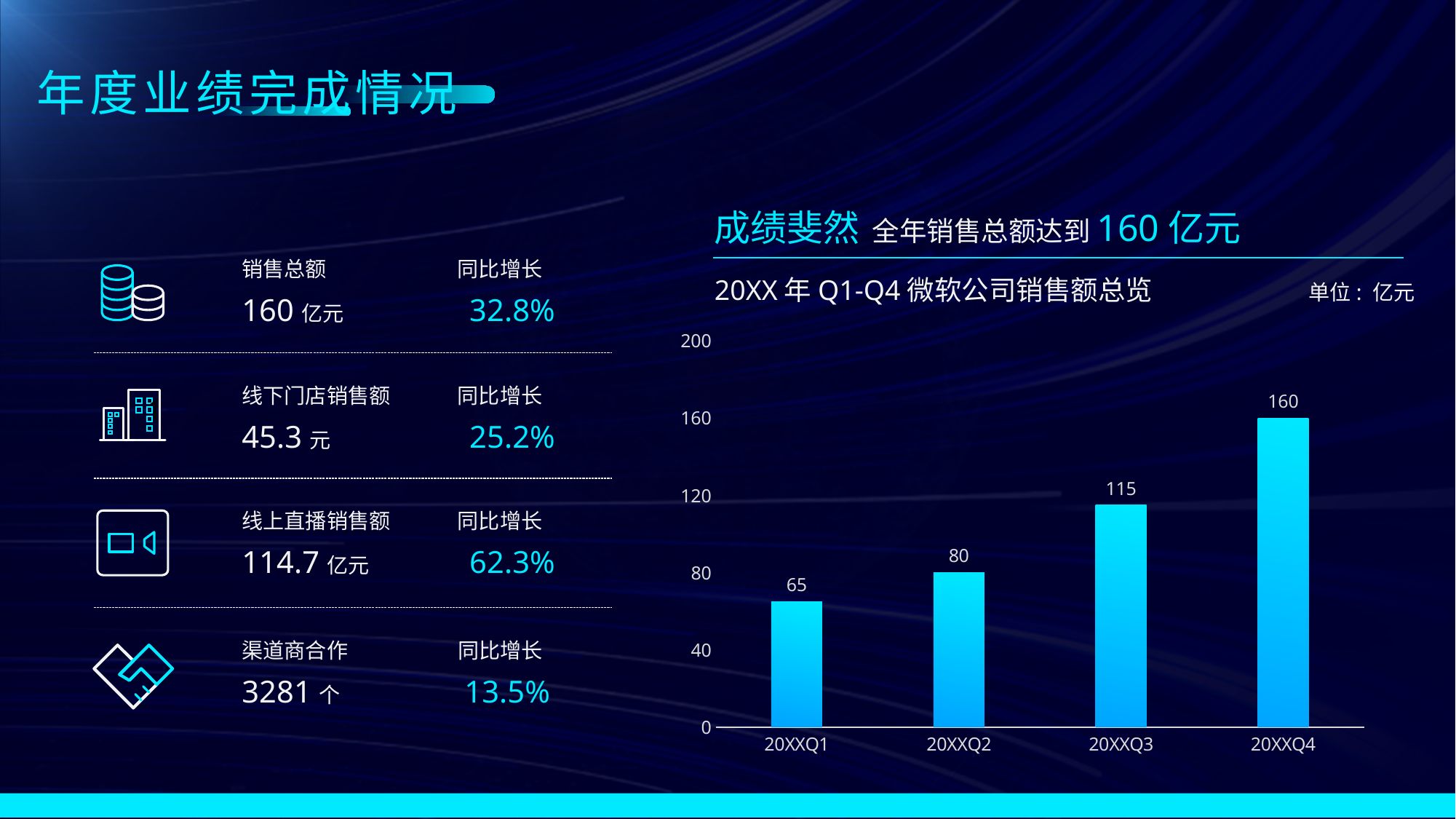
Which quarter has the lowest value? 20XXQ1 What is the title of the chart? 20XX 年 Q1-Q4 微软公司销售额总览 Is the value for 20XXQ3 greater or less than 120? less What is the difference between the values for 20XXQ4 and 20XXQ2? 80 What is the value for 20XXQ1? 65 Do the values rise or fall from 20XXQ1 to 20XXQ4? rise What kind of chart is shown? bar chart What unit is stated for the chart values? 亿元 Which is larger, the value for 20XXQ2 or 20XXQ3? 20XXQ3 Which quarter has the highest value? 20XXQ4 How many quarters are shown on the chart? 4 What is the value for 20XXQ3? 115